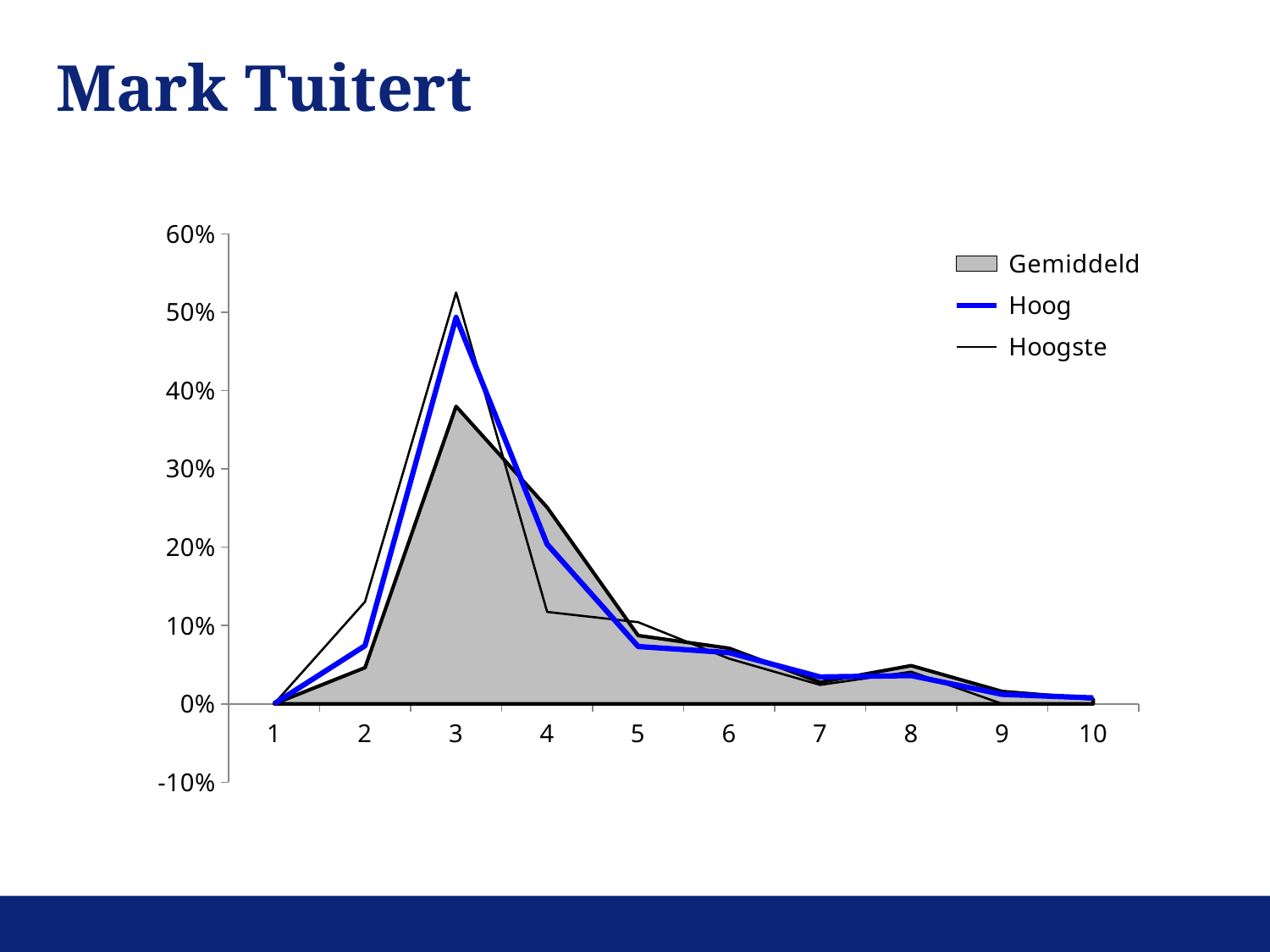
At which x-axis value does the Hoogste series reach its highest point? 3 Is the value of the Gemiddeld series at 3 greater or less than 30%? greater Is the value of the Hoogste series at 4 greater or less than 20%? less Does the Hoog series rise or fall from 3 to 10 along the x axis? fall What is the title of the slide containing the chart? Mark Tuitert At x = 4, which series has the larger value, Hoog or Hoogste? Hoog How many points are plotted along the x axis for each series? 10 Is the value of the Hoog series at 3 greater or less than 40%? greater At which x-axis value does the Gemiddeld series reach its highest point? 3 How many series does the legend list? 3 At which x-axis value does the Hoog series reach its highest point? 3 What colour is the Hoog series line? blue